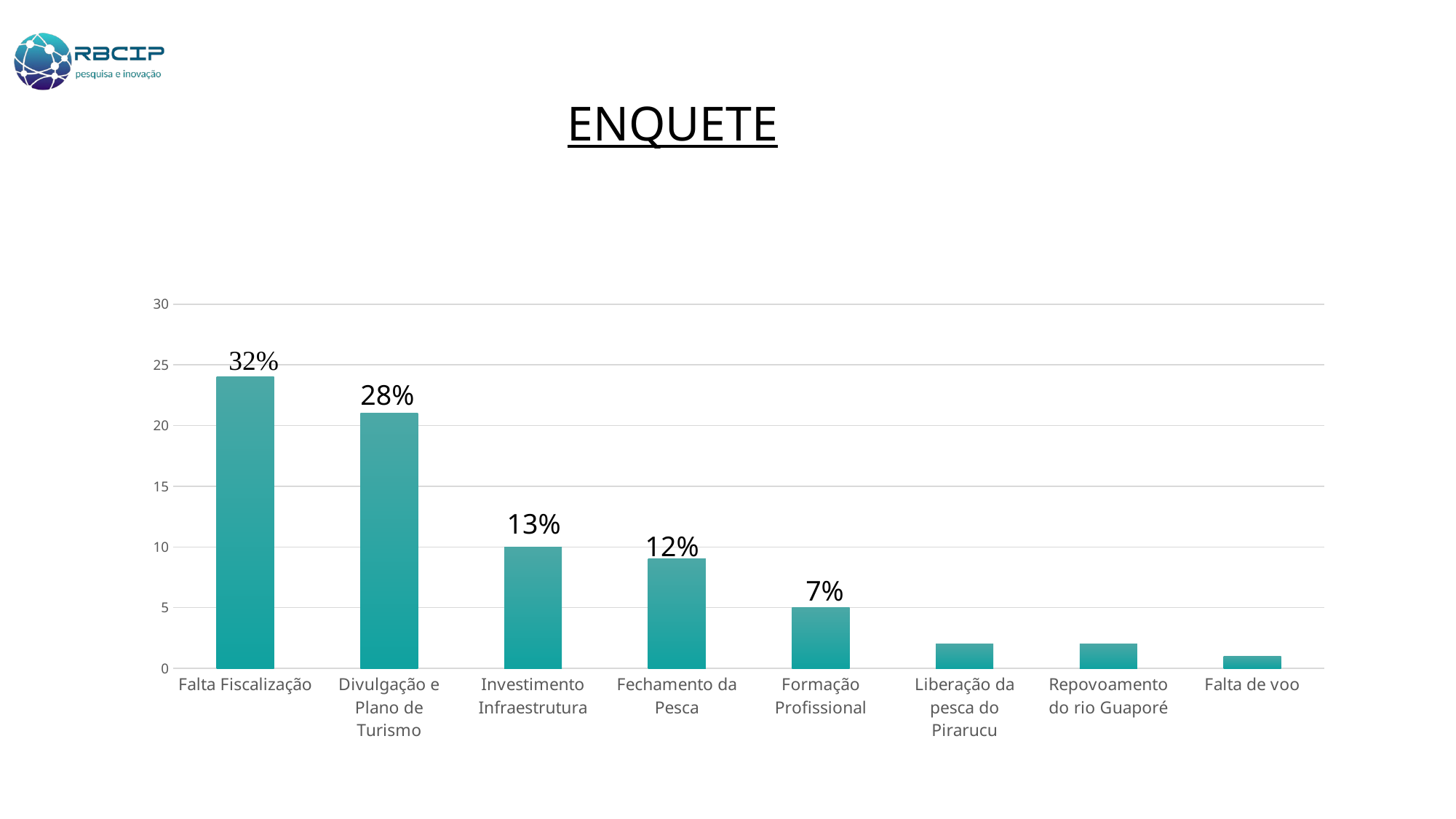
How many categories are shown on the x axis? 8 Do the bar values rise or fall from left to right along the x axis? fall What is the difference between the labelled percentages for Falta Fiscalização and Divulgação e Plano de Turismo? 4% What data label is shown on the bar for Divulgação e Plano de Turismo? 28% Which category has the highest bar? Falta Fiscalização What data label is shown on the bar for Falta Fiscalização? 32% Which has the larger labelled value, Investimento Infraestrutura or Fechamento da Pesca? Investimento Infraestrutura What data label is shown on the bar for Formação Profissional? 7% Is the bar for Liberação da pesca do Pirarucu greater or less than 5 on the axis? less What kind of chart is shown on the slide? bar chart Which category has the lowest bar? Falta de voo Is the bar for Falta Fiscalização greater or less than 20 on the axis? greater